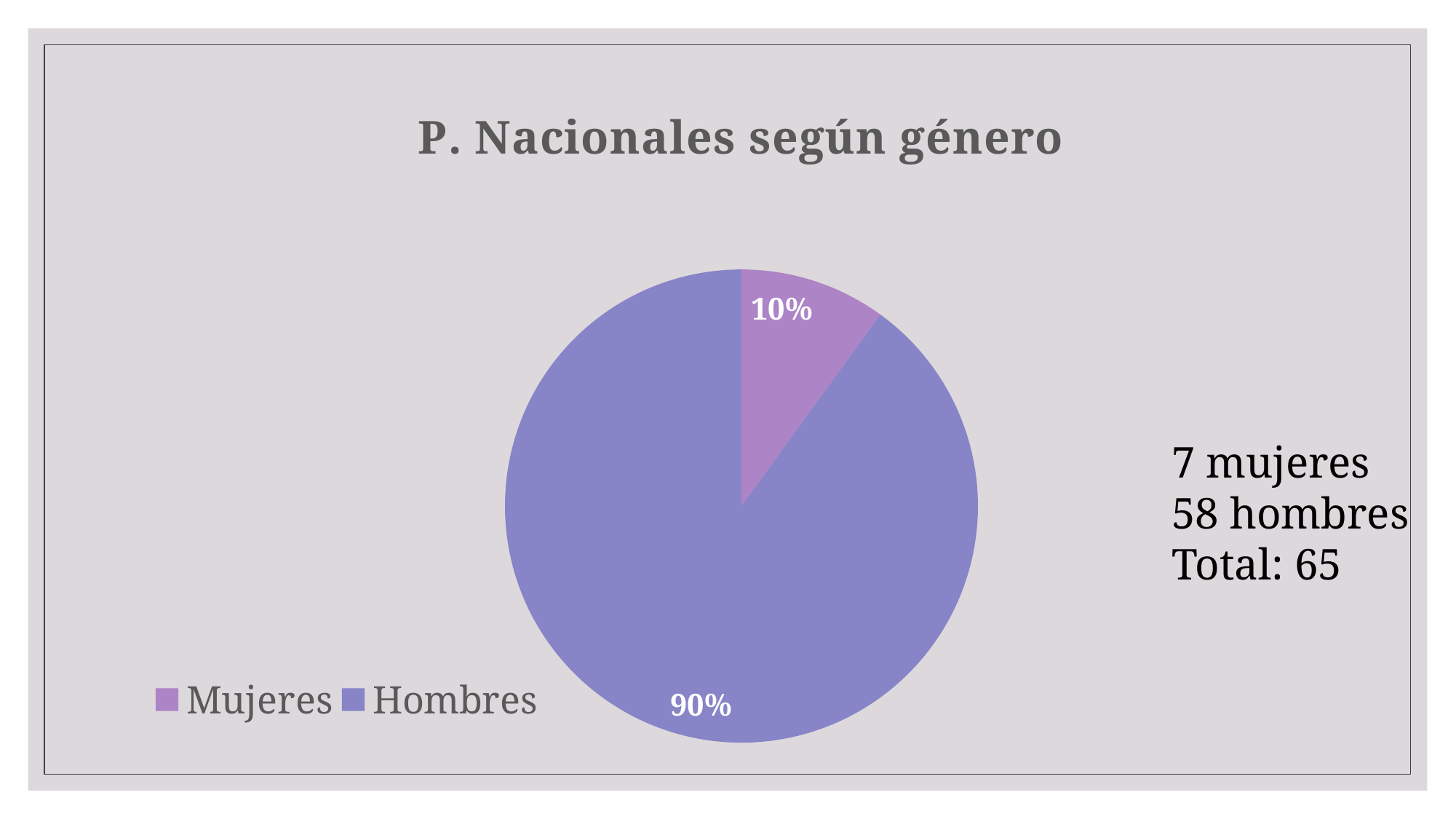
What kind of chart is shown on the slide? pie chart According to the text next to the chart, what is the total number of people? 65 Which category has the largest share of the pie? Hombres What is the title of the chart? P. Nacionales según género How many entries does the legend list? 2 What percentage of the pie does Mujeres represent? 10% How many categories does the pie chart have? 2 Which category has the smallest share of the pie? Mujeres What is the difference in percentage points between the Hombres share and the Mujeres share? 80% According to the text next to the chart, how many mujeres are there? 7 What percentage of the pie does Hombres represent? 90% Which is larger, the share for Mujeres or the share for Hombres? Hombres